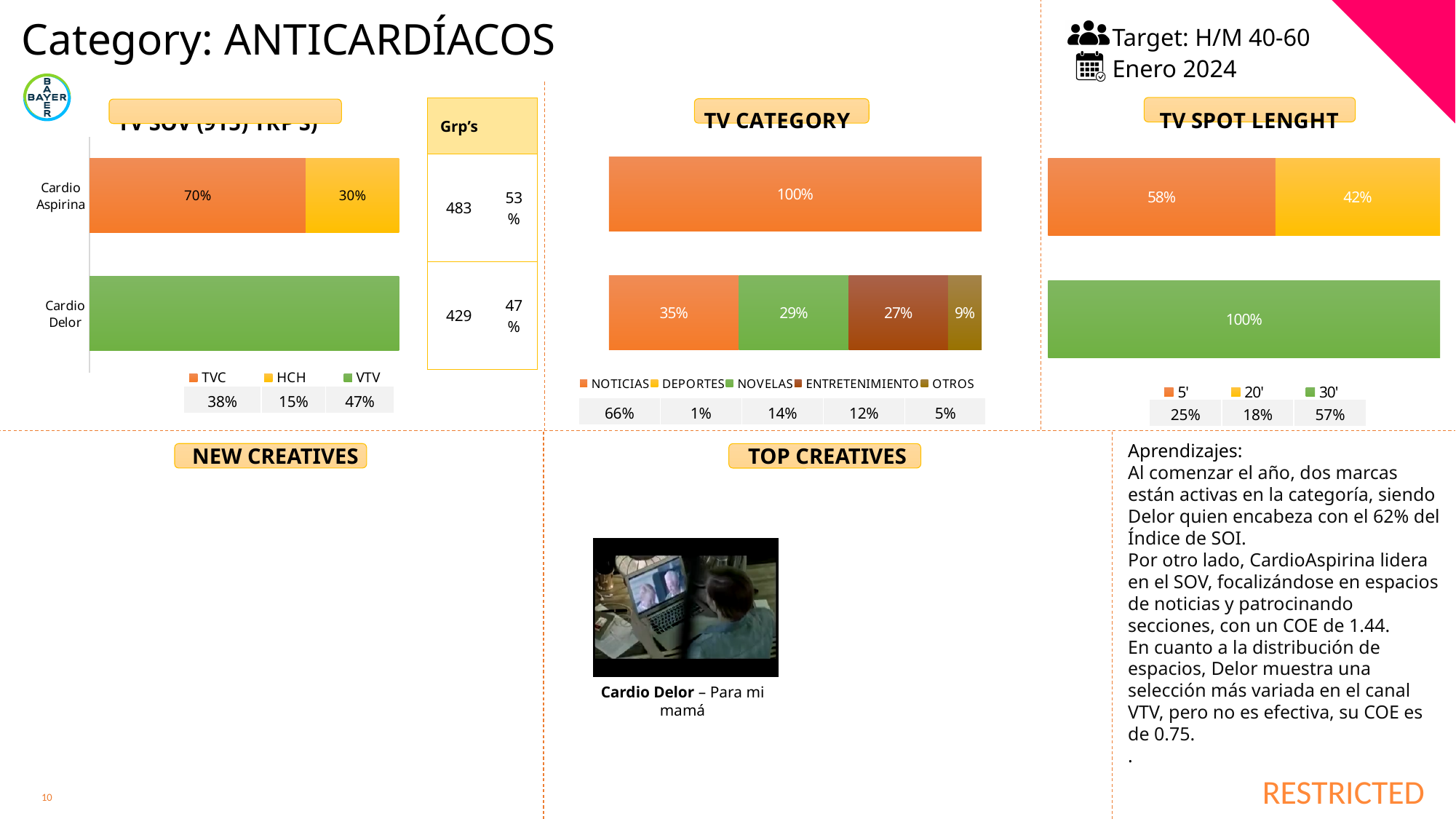
In the TV CATEGORY chart, which segment of the bottom bar is the smallest? OTROS In the TV SOV chart, what is the TVC value for Cardio Aspirina? 70% In the TV CATEGORY chart, what value is labelled on the top bar? 100% In the TV SOV chart, what is the HCH value for Cardio Aspirina? 30% In the TV CATEGORY chart, what is the difference between the NOTICIAS and OTROS values in the bottom bar? 26 percentage points In the TV SPOT LENGHT chart, what is the 5' value in the top bar? 58% In the TV SOV chart, how many series does the legend list? 3 In the TV CATEGORY chart, how many series does the legend list? 5 In the TV CATEGORY chart, what is the NOTICIAS value in the bottom bar? 35% In the TV SPOT LENGHT chart, which is larger in the top bar, 5' or 20'? 5' What kind of chart is the TV SOV chart? Bar chart In the TV SOV chart, what is the difference between the TVC and HCH values for Cardio Aspirina? 40 percentage points